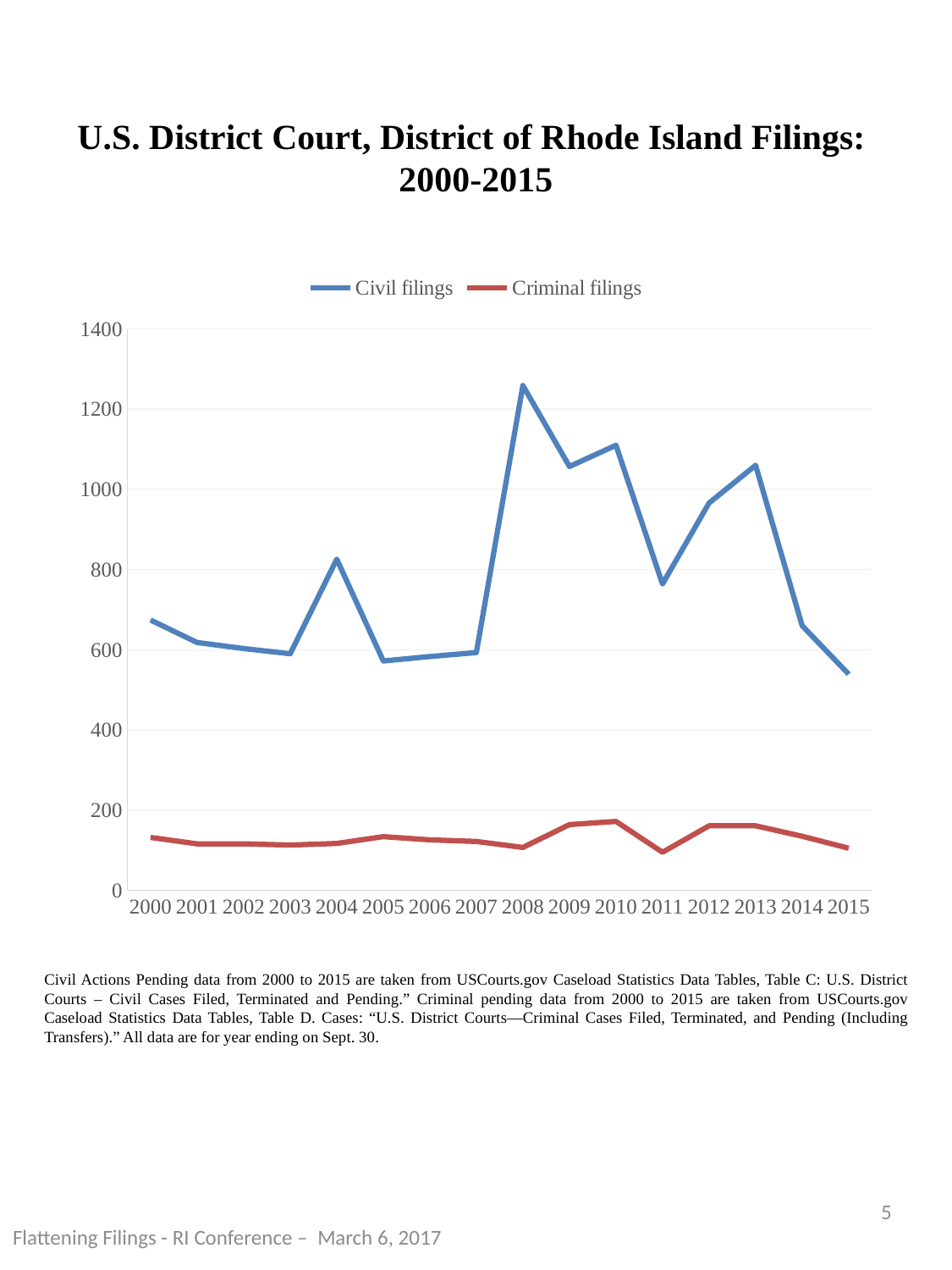
Which year had more civil filings, 2008 or 2010? 2008 How many years are plotted along the x axis? 16 In which year were criminal filings lowest? 2011 What kind of chart is shown on the slide? Line chart Is the value for civil filings in 2005 greater or less than 600? less Is the value for civil filings in 2008 greater or less than 1200? greater How many series does the legend list? 2 Is the value for civil filings in 2004 greater or less than 800? greater In which year were civil filings highest? 2008 What colour is the line for civil filings? Blue Do civil filings rise or fall from 2013 to 2015? Fall